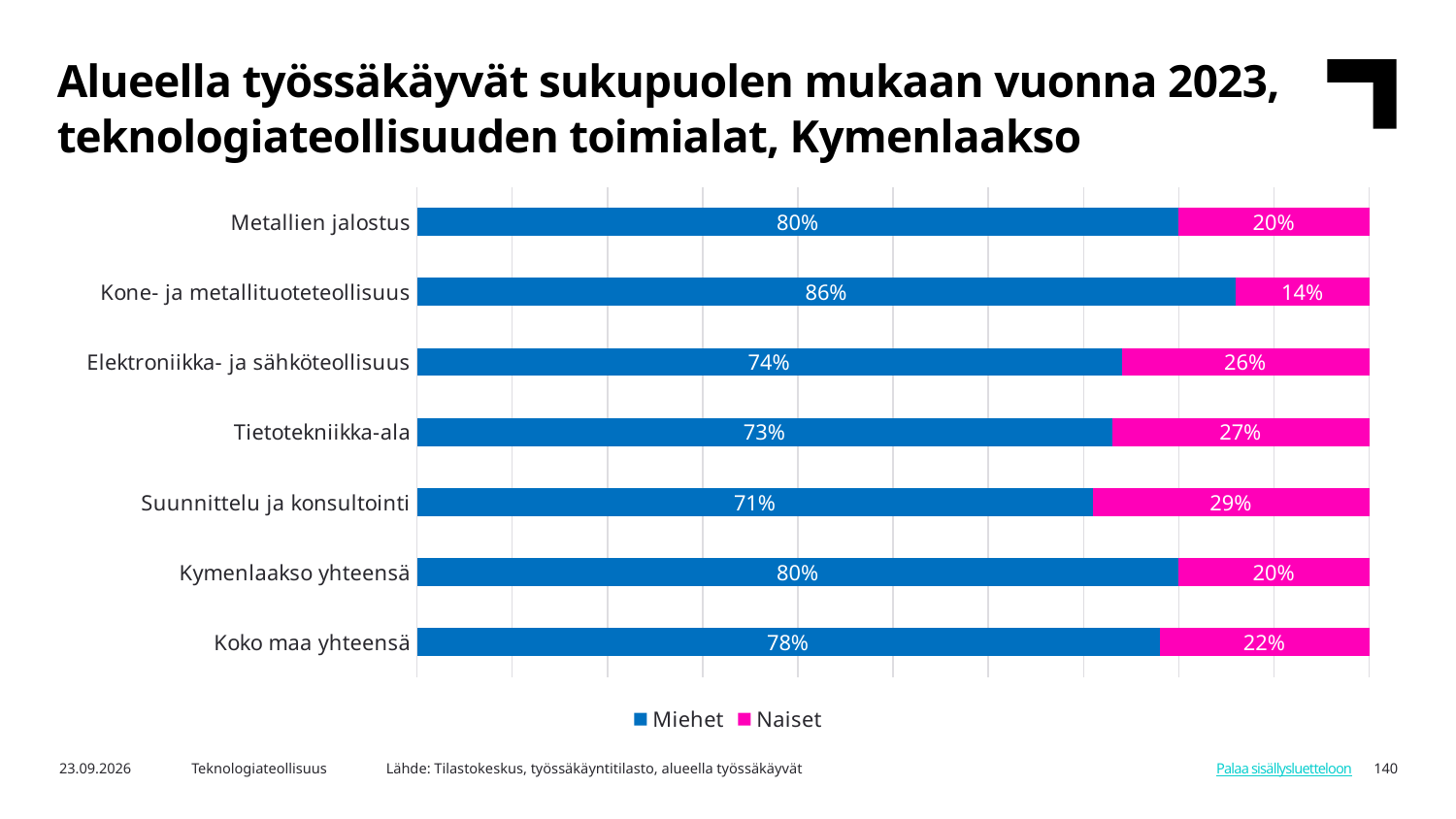
How many categories are shown on the chart? 7 What is the total of the stacked bar for Kymenlaakso yhteensä? 100% How many series does the legend list? 2 What kind of chart is shown on the slide? Stacked bar chart What is the difference between the Naiset share for Tietotekniikka-ala and the Naiset share for Kone- ja metallituoteteollisuus? 13% Which is larger: the Naiset share for Elektroniikka- ja sähköteollisuus or the Naiset share for Metallien jalostus? Elektroniikka- ja sähköteollisuus What is the Naiset share for Suunnittelu ja konsultointi? 29% Which category has the lowest Miehet share? Suunnittelu ja konsultointi What is the Naiset share for Koko maa yhteensä? 22% Which series is shown in pink? Naiset What is the Miehet share for Kone- ja metallituoteteollisuus? 86% Which category has the highest Miehet share? Kone- ja metallituoteteollisuus